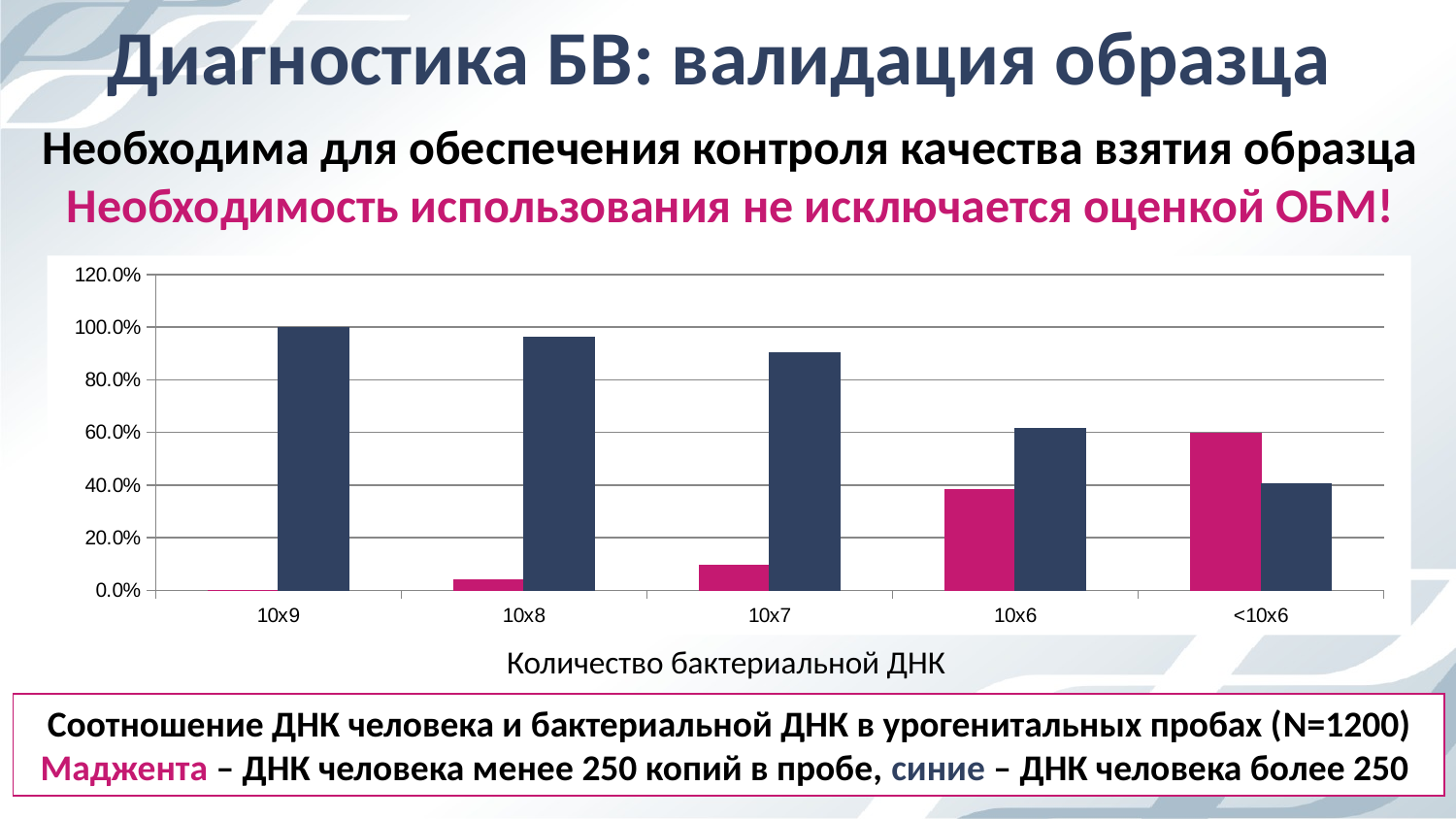
What is the title of the x axis of the chart? Количество бактериальной ДНК For which category is the magenta bar the highest? <10x6 Is the value of the blue bar for 10x8 greater or less than 80.0%? greater What kind of chart is shown on the slide? bar chart What is the value of the blue bar for the 10x9 category? 100.0% Is the value of the magenta bar for <10x6 greater or less than 40.0%? greater Is the value of the magenta bar for 10x7 greater or less than 20.0%? less Do the blue bars rise or fall moving from 10x9 to <10x6 along the x axis? fall How many categories are shown on the x axis of the chart? 5 For which category is the blue bar the highest? 10x9 For which category is the blue bar the lowest? <10x6 For the <10x6 category, which bar is larger, the magenta or the blue one? magenta